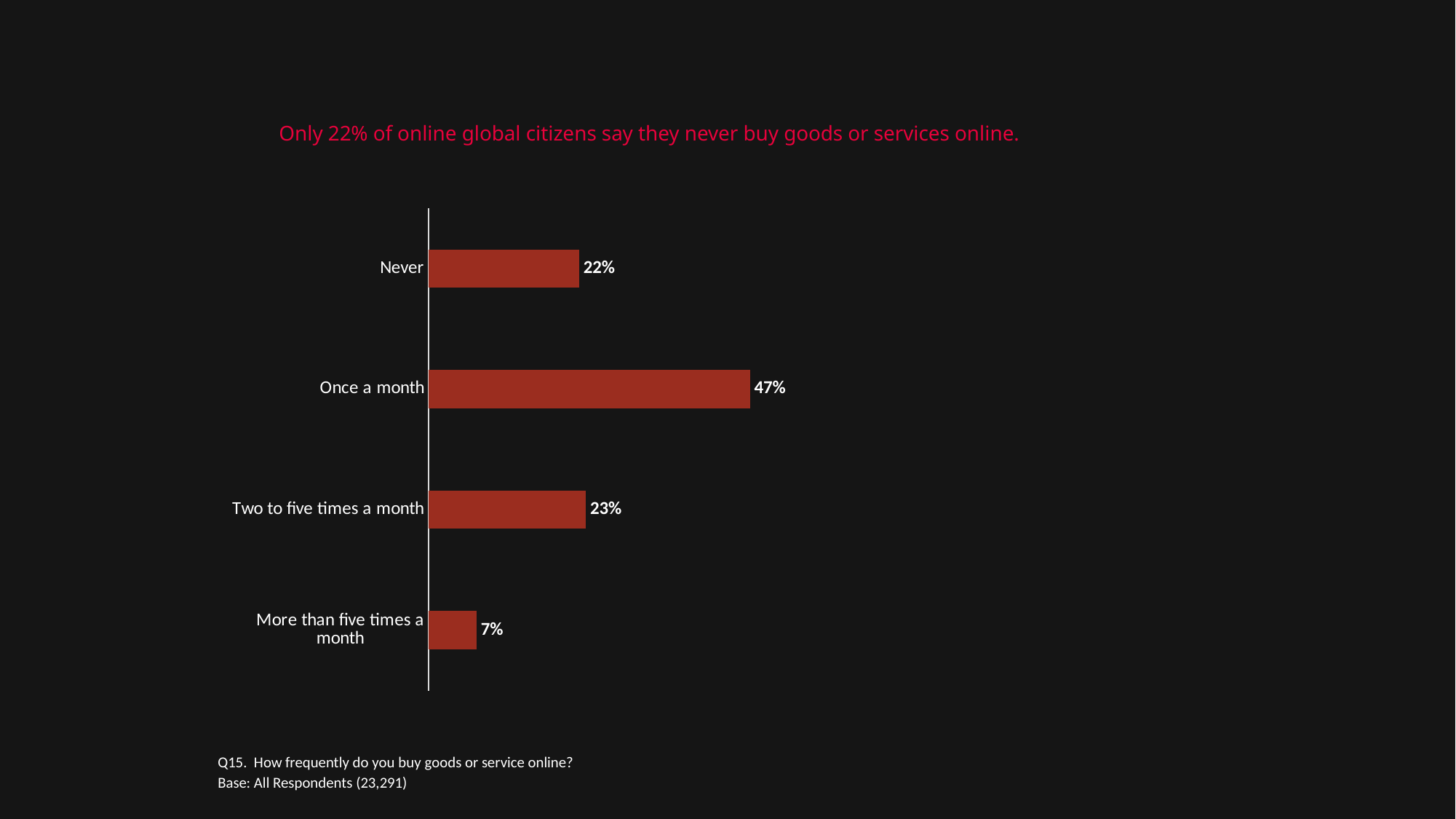
What percentage of respondents say they never buy goods or services online? 22% What is the difference between the values for 'Once a month' and 'Never'? 25% Which category has the lowest value? More than five times a month Which is larger, the value for 'Never' or the value for 'Once a month'? Once a month How many categories are shown in the chart? 4 Which category has the highest value? Once a month What is the value for 'Once a month'? 47% What kind of chart is shown on the slide? Bar chart What is the base (number of respondents) stated on the slide? 23,291 What is the value for 'Two to five times a month'? 23% What is the difference between the values for 'Two to five times a month' and 'More than five times a month'? 16% What is the value for 'More than five times a month'? 7%